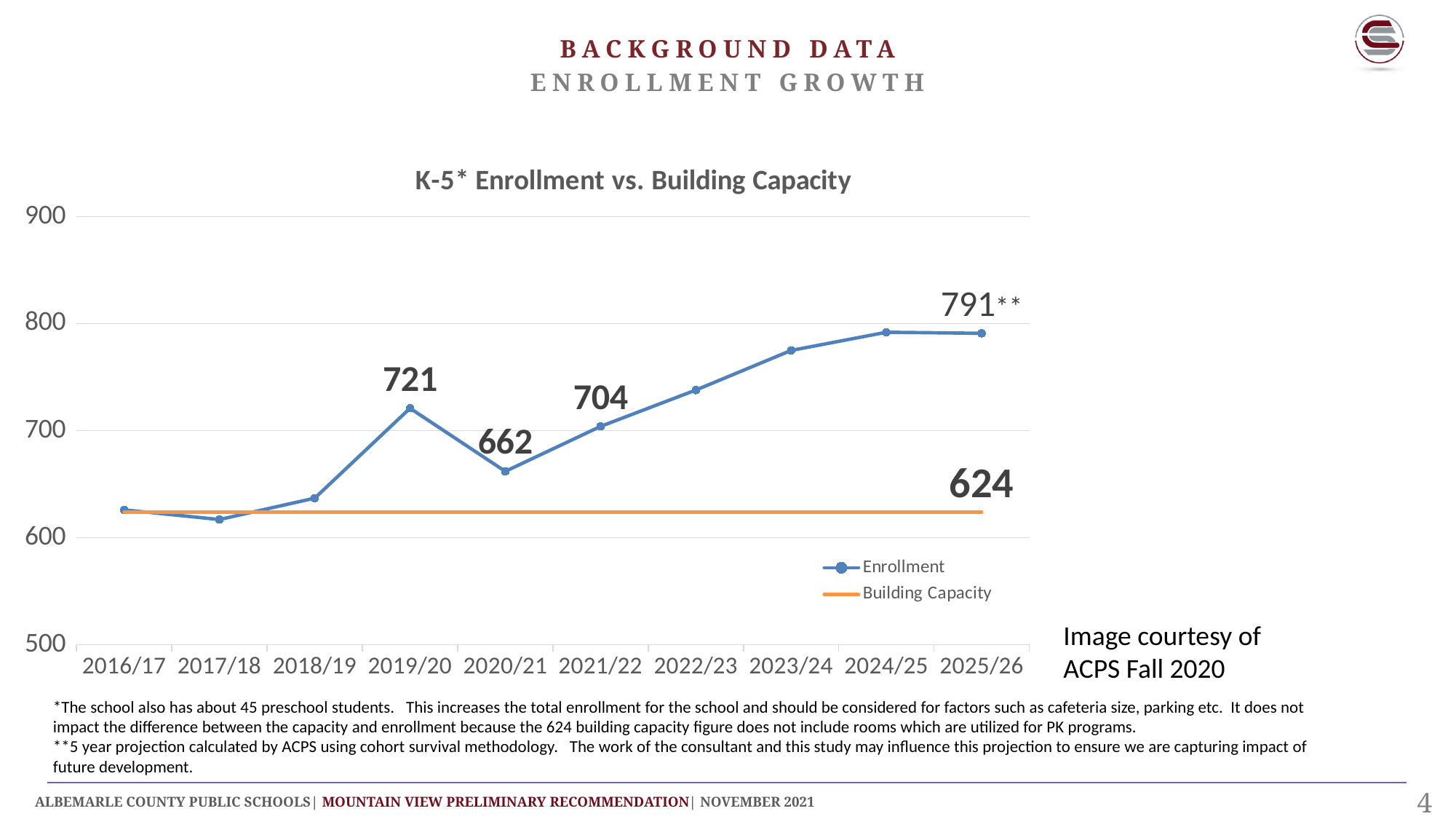
What is the K-5 enrollment value shown for 2020/21? 662 How many school years are shown on the x axis? 10 Which year had higher enrollment, 2019/20 or 2021/22? 2019/20 By how much did enrollment drop from 2019/20 to 2020/21? 59 What is the K-5 enrollment value shown for 2019/20? 721 How much does the projected 2025/26 enrollment of 791 exceed the building capacity of 624? 167 Is the enrollment value for 2023/24 greater or less than 700? greater What is the building capacity value shown on the chart? 624 What is the projected K-5 enrollment value labelled for 2025/26? 791 What is the K-5 enrollment value shown for 2021/22? 704 What type of chart is used to show K-5 Enrollment vs. Building Capacity? Line chart How many series does the legend list? 2